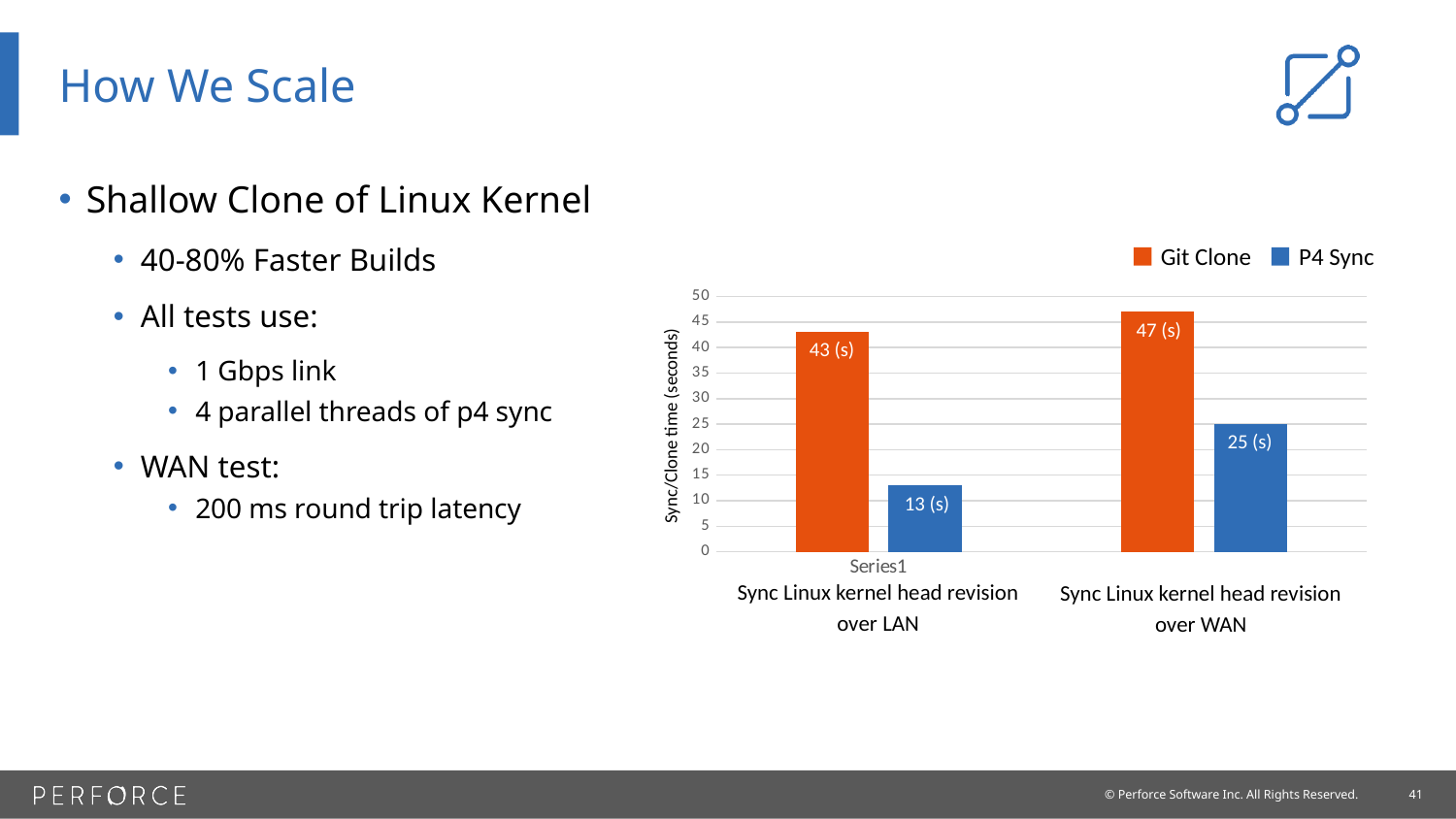
Which bar has the lowest value in the chart? P4 Sync over LAN What is the P4 Sync value for Sync Linux kernel head revision over LAN? 13 (s) What kind of chart is shown on the slide? Bar chart Which series has the highest value in the chart? Git Clone What is the label of the y axis of the chart? Sync/Clone time (seconds) What is the difference between Git Clone and P4 Sync for Sync Linux kernel head revision over LAN? 30 (s) Which is larger for Sync Linux kernel head revision over WAN, Git Clone or P4 Sync? Git Clone What is the Git Clone value for Sync Linux kernel head revision over LAN? 43 (s) What is the P4 Sync value for Sync Linux kernel head revision over WAN? 25 (s) What is the difference between Git Clone and P4 Sync for Sync Linux kernel head revision over WAN? 22 (s) How many categories are shown on the x axis of the chart? 2 How many series does the legend list? 2